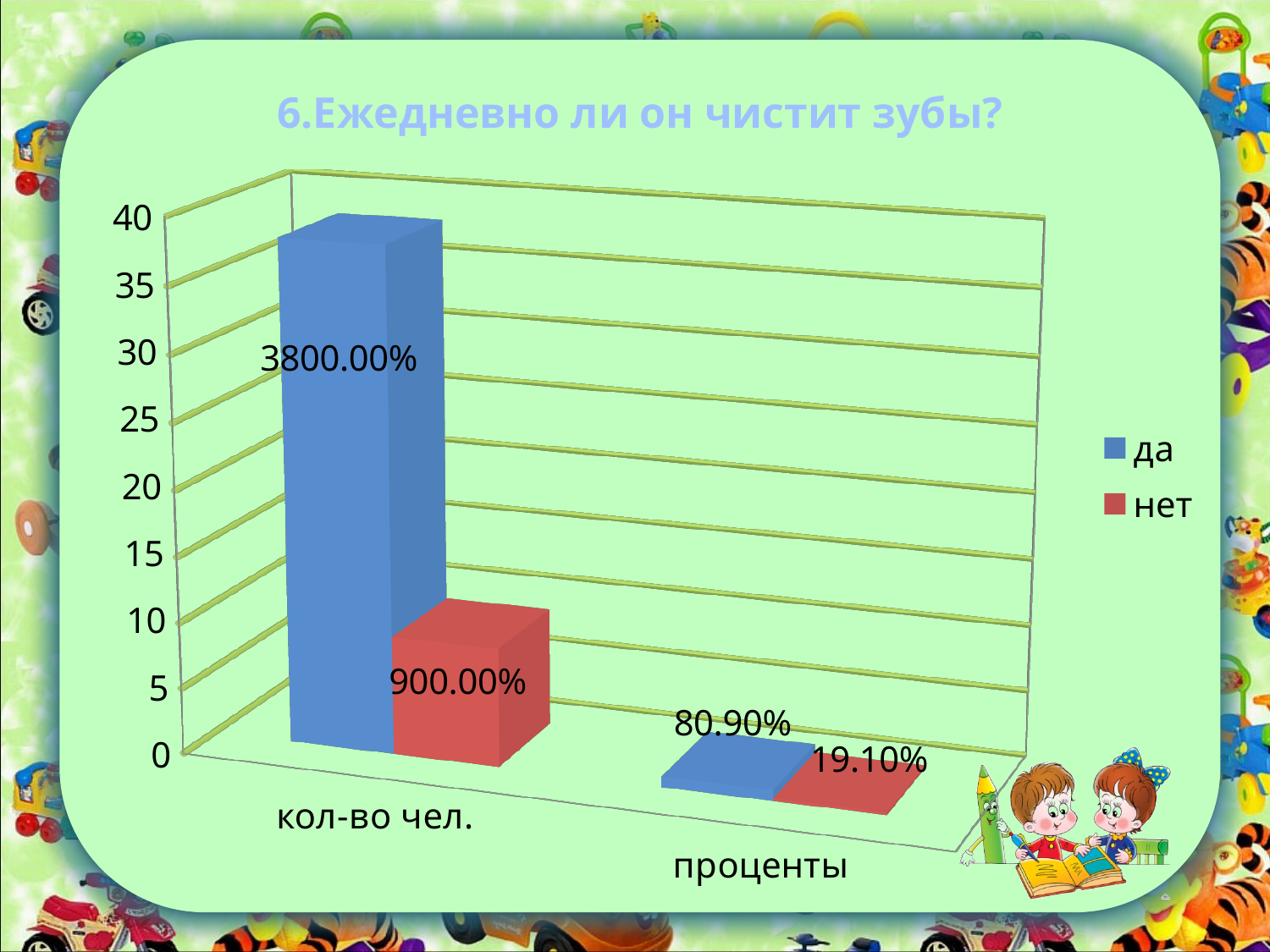
What is the data label on the "да" bar for "проценты"? 80.90% What kind of chart is shown on the slide? bar chart For "проценты", which is larger: "да" or "нет"? да What is the data label on the "да" bar for "кол-во чел."? 3800.00% Which bar is the lowest in the chart? нет for проценты How many series does the legend list? 2 What is the difference between the "да" and "нет" labels for "кол-во чел."? 2900.00% How many categories are shown on the x axis? 2 Is the "да" bar for "кол-во чел." greater or less than 35 on the axis? greater What is the data label on the "нет" bar for "кол-во чел."? 900.00% What is the data label on the "нет" bar for "проценты"? 19.10% Which series has the tallest bar in the chart? да